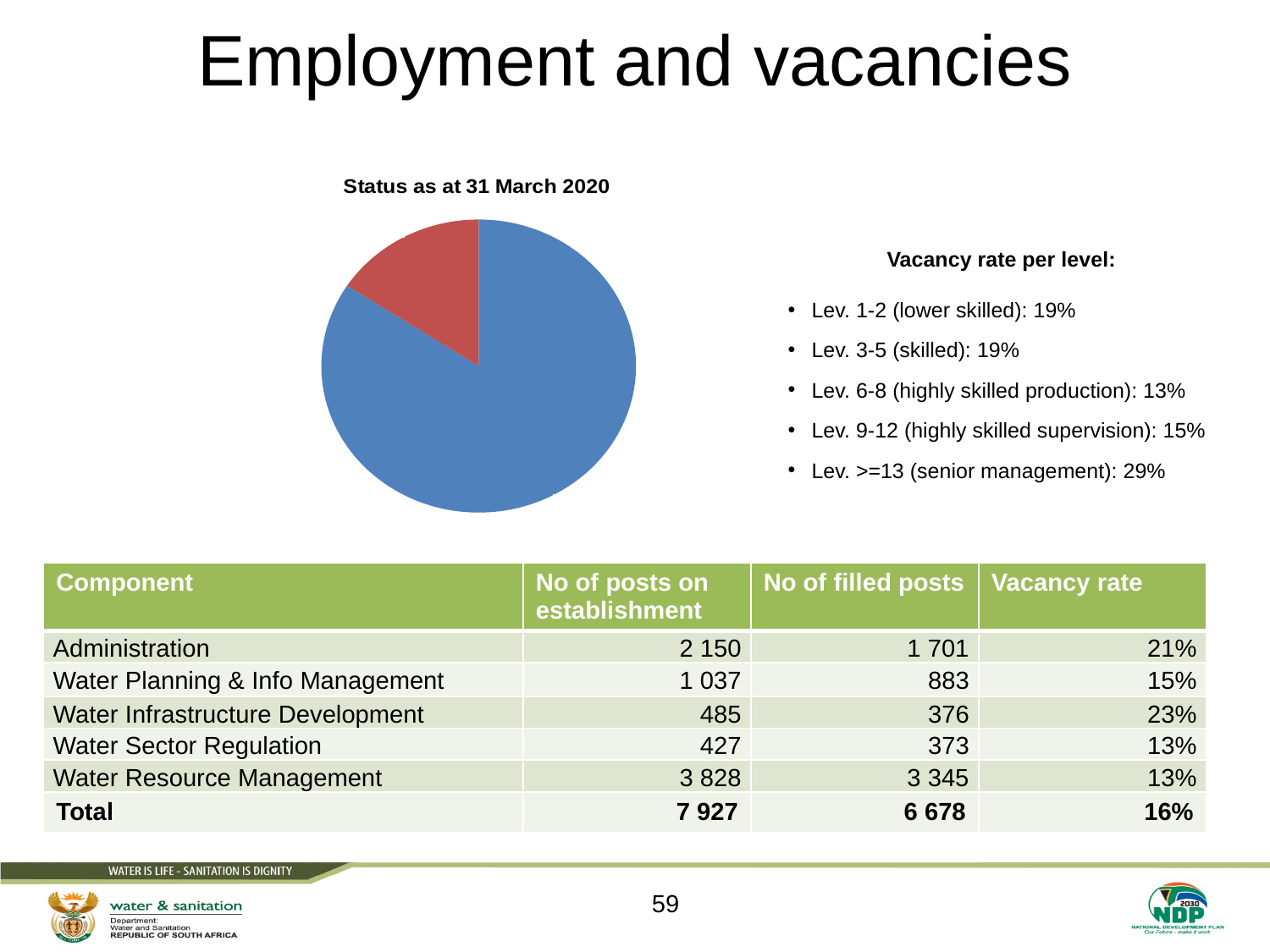
Which slice of the pie chart is larger, the blue one or the red one? the blue one How many slices does the pie chart have? 2 What kind of chart is shown on the slide? pie chart Which slice of the pie chart is the smallest? the red slice What is the title of the pie chart? Status as at 31 March 2020 What colour is the largest slice of the pie chart? blue